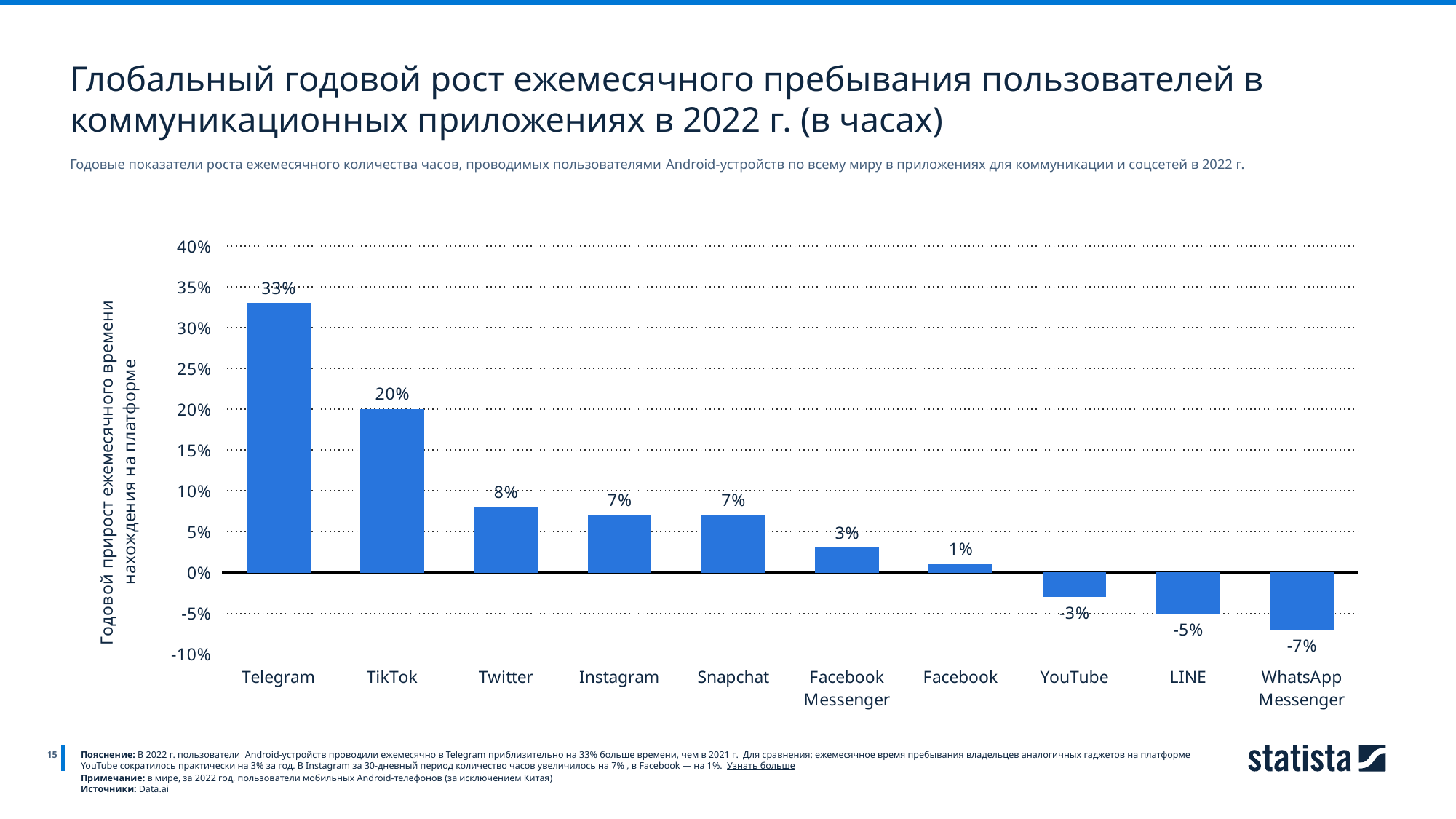
What kind of chart is shown on the slide? bar chart What is the value for WhatsApp Messenger? -7% What is the value for TikTok? 20% Which category has the lowest value? WhatsApp Messenger What is the difference between the values for Telegram and TikTok? 13% Which category has the highest value? Telegram Is the value for YouTube greater or less than 0%? less Which is larger, the value for Twitter or the value for Facebook? Twitter What is the value for Facebook Messenger? 3% Do the values rise or fall from left to right along the x axis? fall How many categories are shown on the x axis? 10 What is the value for Telegram? 33%